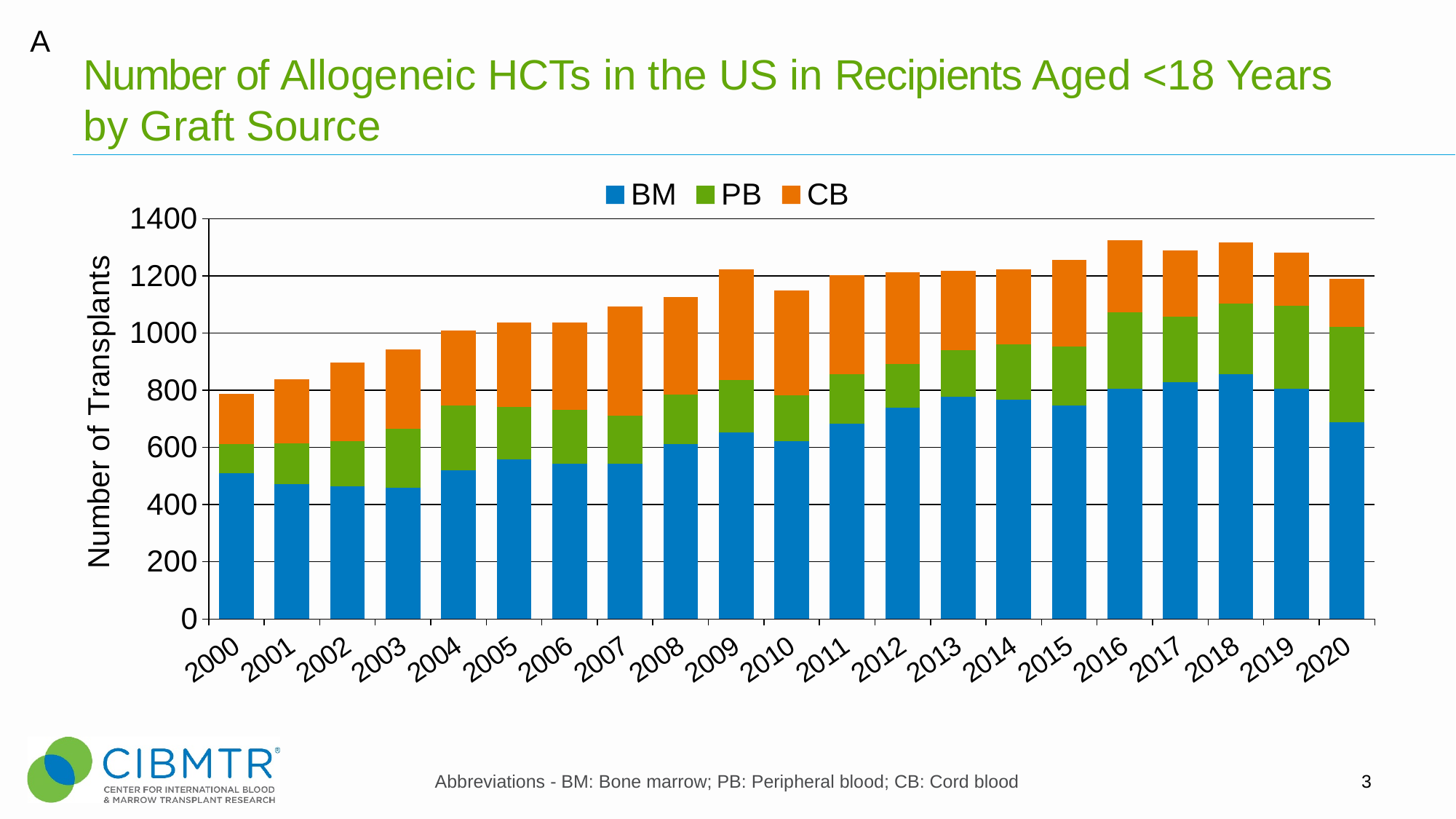
Which year has the lowest total number of transplants? 2000 How many series does the legend list? 3 Does the total number of transplants generally rise or fall from 2000 to 2016? rise Which is larger, the BM value for 2018 or the BM value for 2000? 2018 How many years are shown along the x axis? 21 Is the total number of transplants in 2020 greater or less than 1000? greater What does the abbreviation CB stand for according to the slide? Cord blood Is the total number of transplants in 2016 greater or less than 1200? greater Is the BM value for 2003 greater or less than 600? less What kind of chart is shown on the slide? Stacked bar chart